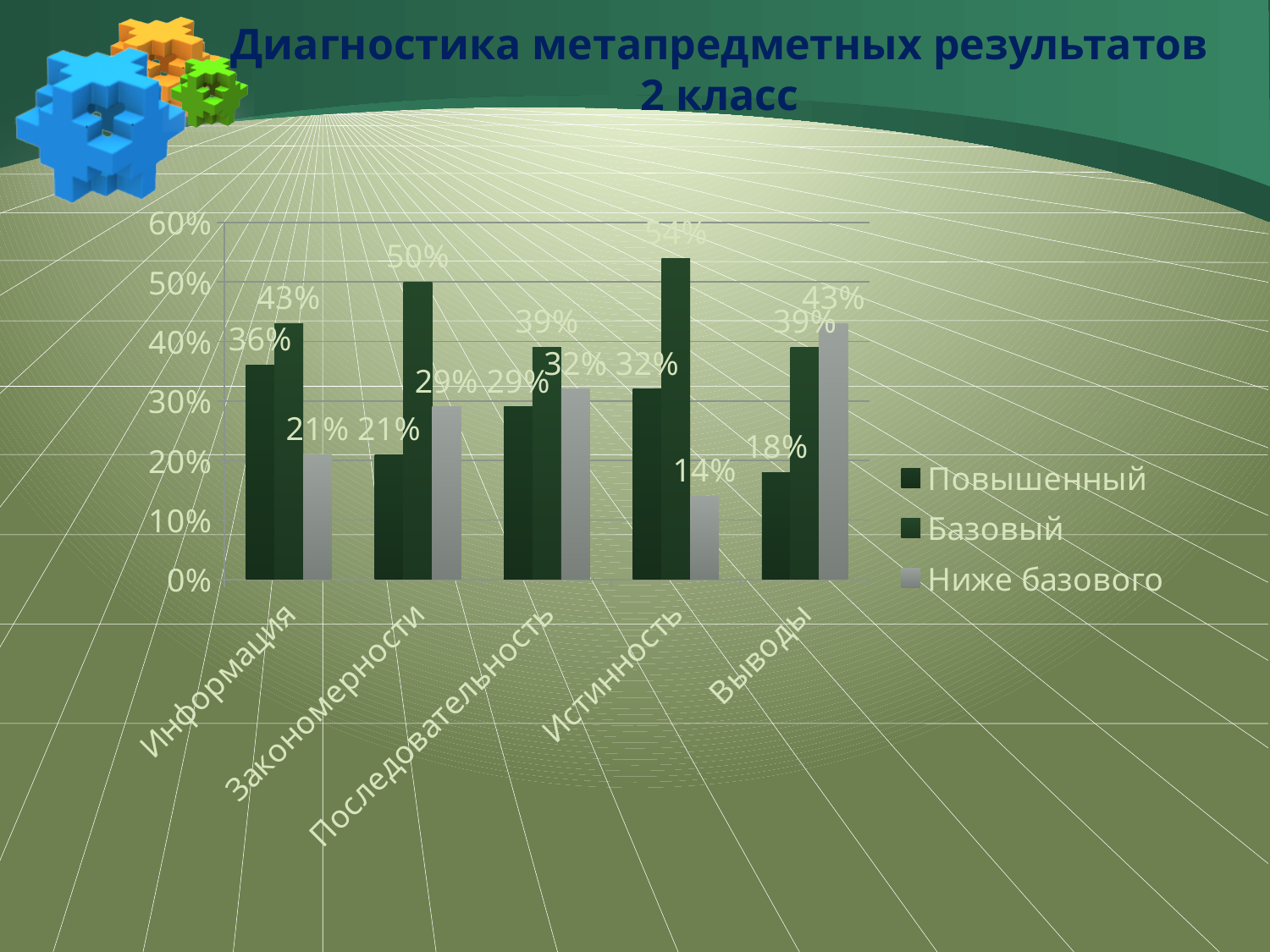
Which is larger for Выводы: Повышенный or Ниже базового? Ниже базового What is the difference between the Базовый and Повышенный values for Закономерности? 29% What is the value of Повышенный for Информация? 36% Which category has the highest Базовый value? Истинность How many categories are shown on the x axis of the chart? 5 What type of chart is shown on the slide? Bar chart Which category has the lowest Ниже базового value? Истинность What is the title of the slide containing the chart? Диагностика метапредметных результатов 2 класс How many series does the chart legend list? 3 Is the Базовый value for Закономерности greater or less than 40%? greater What is the value of Базовый for Истинность? 54% What is the value of Ниже базового for Выводы? 43%